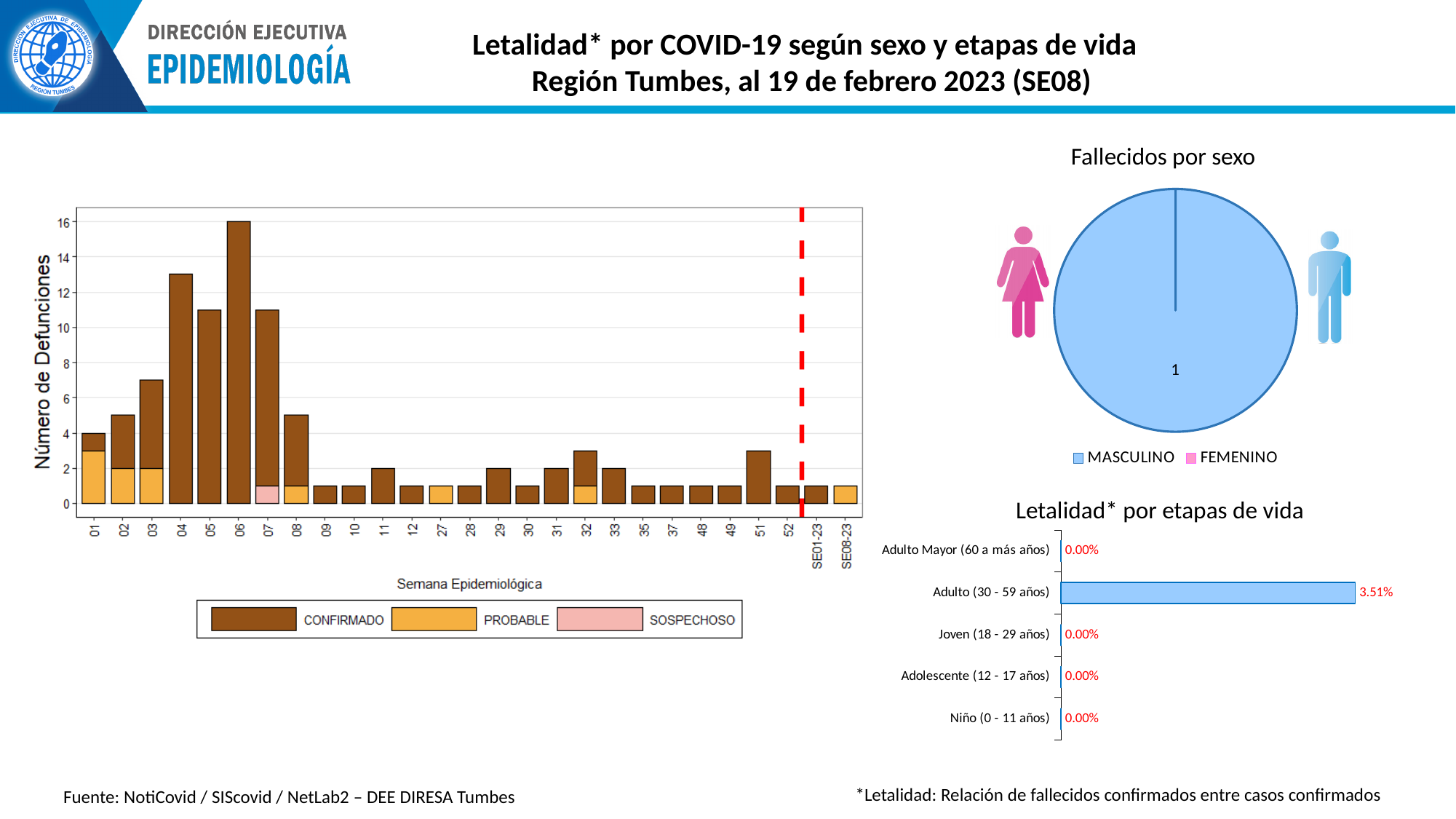
What kind of chart is 'Letalidad* por etapas de vida'? Bar chart In the 'Fallecidos por sexo' pie chart, which sex has the larger share, MASCULINO or FEMENINO? MASCULINO In the 'Letalidad* por etapas de vida' chart, what is the value for Adulto (30 - 59 años)? 3.51% In the 'Letalidad* por etapas de vida' chart, which life stage has the highest letalidad? Adulto (30 - 59 años) In the 'Fallecidos por sexo' pie chart, what value is printed on the MASCULINO slice? 1 In the 'Letalidad* por etapas de vida' chart, what is the value for Joven (18 - 29 años)? 0.00% In the left chart of deaths by Semana Epidemiológica, is the total for week 04 greater or less than 12? greater How many series does the legend of the left chart of deaths by Semana Epidemiológica list? 3 How many life-stage categories are shown in the 'Letalidad* por etapas de vida' chart? 5 How many entries does the legend of the 'Fallecidos por sexo' pie chart list? 2 In the left chart of deaths by Semana Epidemiológica, what is the total number of deaths in week 06? 16 In the left chart of deaths by Semana Epidemiológica, which week has the highest number of deaths? 06